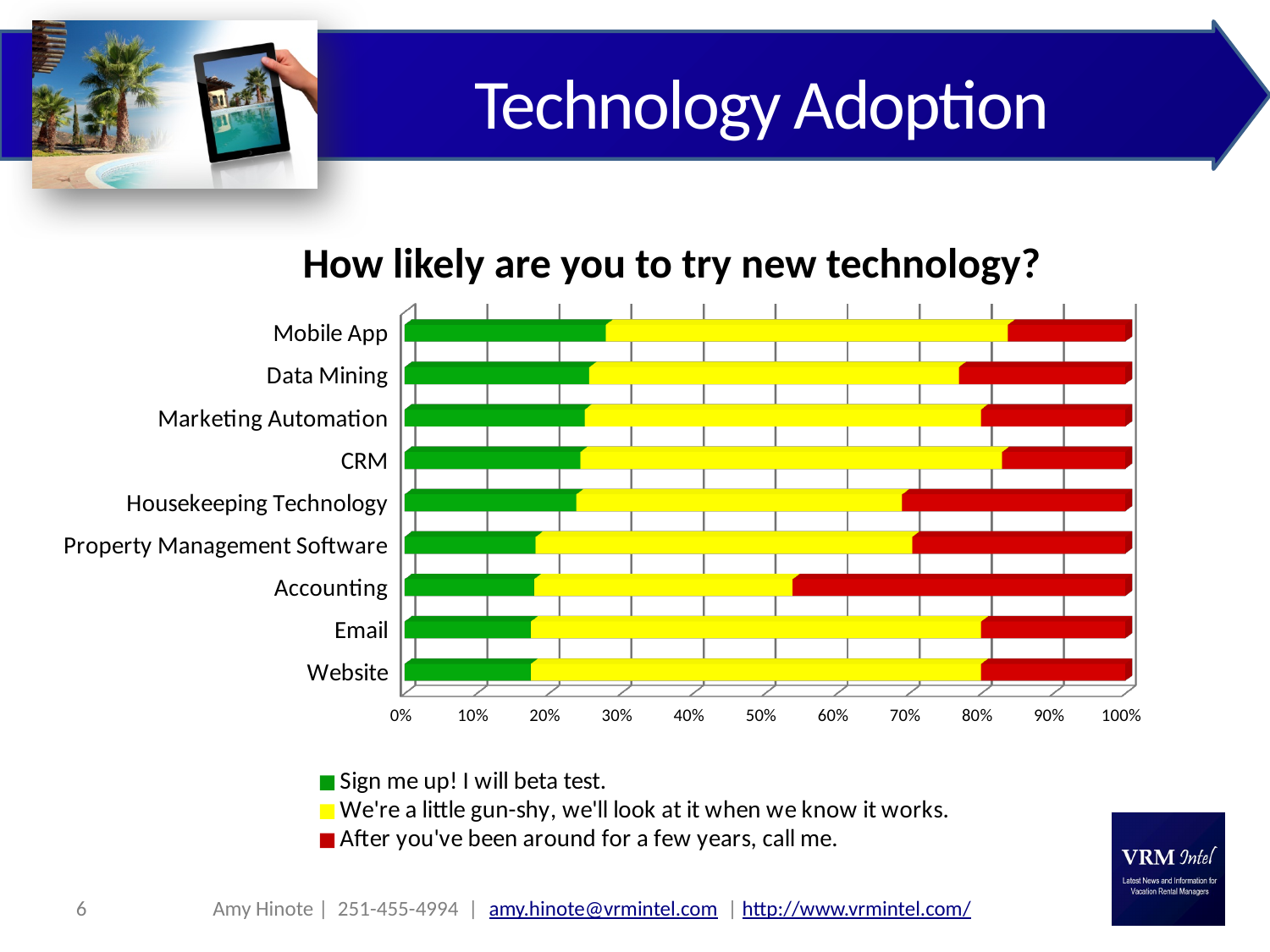
Is the green "Sign me up! I will beta test." share for Website greater or less than 20%? less Is the red "After you've been around for a few years, call me." share for Accounting greater or less than 40%? greater Which legend entry is shown in red? After you've been around for a few years, call me. What is the title of the chart? How likely are you to try new technology? Which has a larger green segment, Mobile App or Website? Mobile App Which has a larger red segment, Accounting or Mobile App? Accounting How many series does the chart's legend list? 3 Is the green "Sign me up! I will beta test." share for Mobile App greater or less than 20%? greater Which category has the largest red segment ("After you've been around for a few years, call me.")? Accounting What kind of chart is shown on the slide? bar chart How many technology categories are listed on the chart? 9